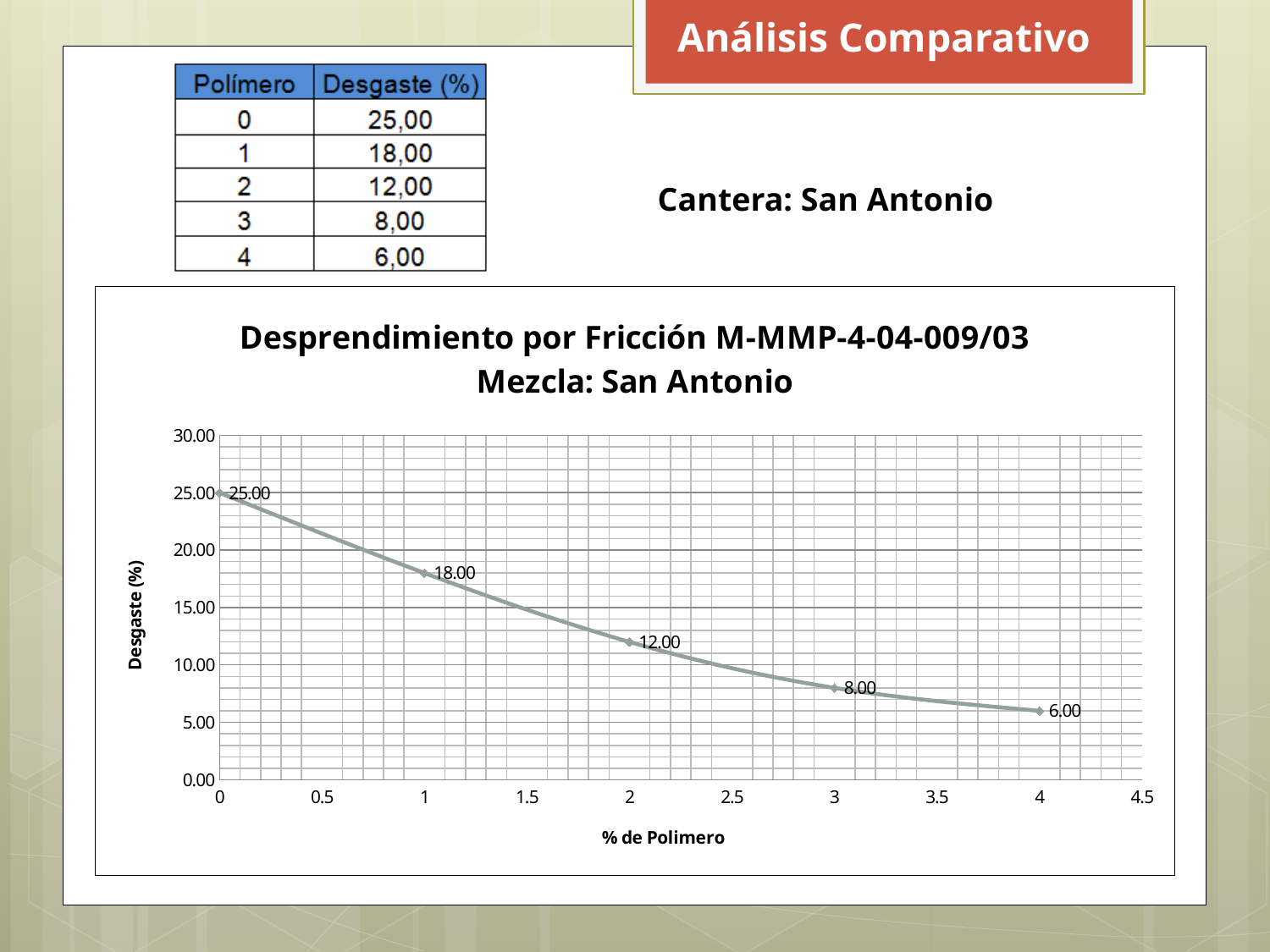
At which % de Polimero is the Desgaste (%) lowest? 4 Is the Desgaste (%) value at 3% de Polimero greater or less than 10.00? less What is the difference in Desgaste (%) between 1% and 3% de Polimero? 10.00 Does the Desgaste (%) rise or fall as % de Polimero increases? fall What is the Desgaste (%) value at 2% de Polimero? 12.00 What kind of chart is shown on the slide? line chart What is the Desgaste (%) value at 4% de Polimero? 6.00 Which has a higher Desgaste (%): 1% de Polimero or 2% de Polimero? 1% de Polimero What is the Desgaste (%) value at 0% de Polimero? 25.00 How many data points are plotted on the chart? 5 At which % de Polimero is the Desgaste (%) highest? 0 What is the label of the x axis of the chart? % de Polimero